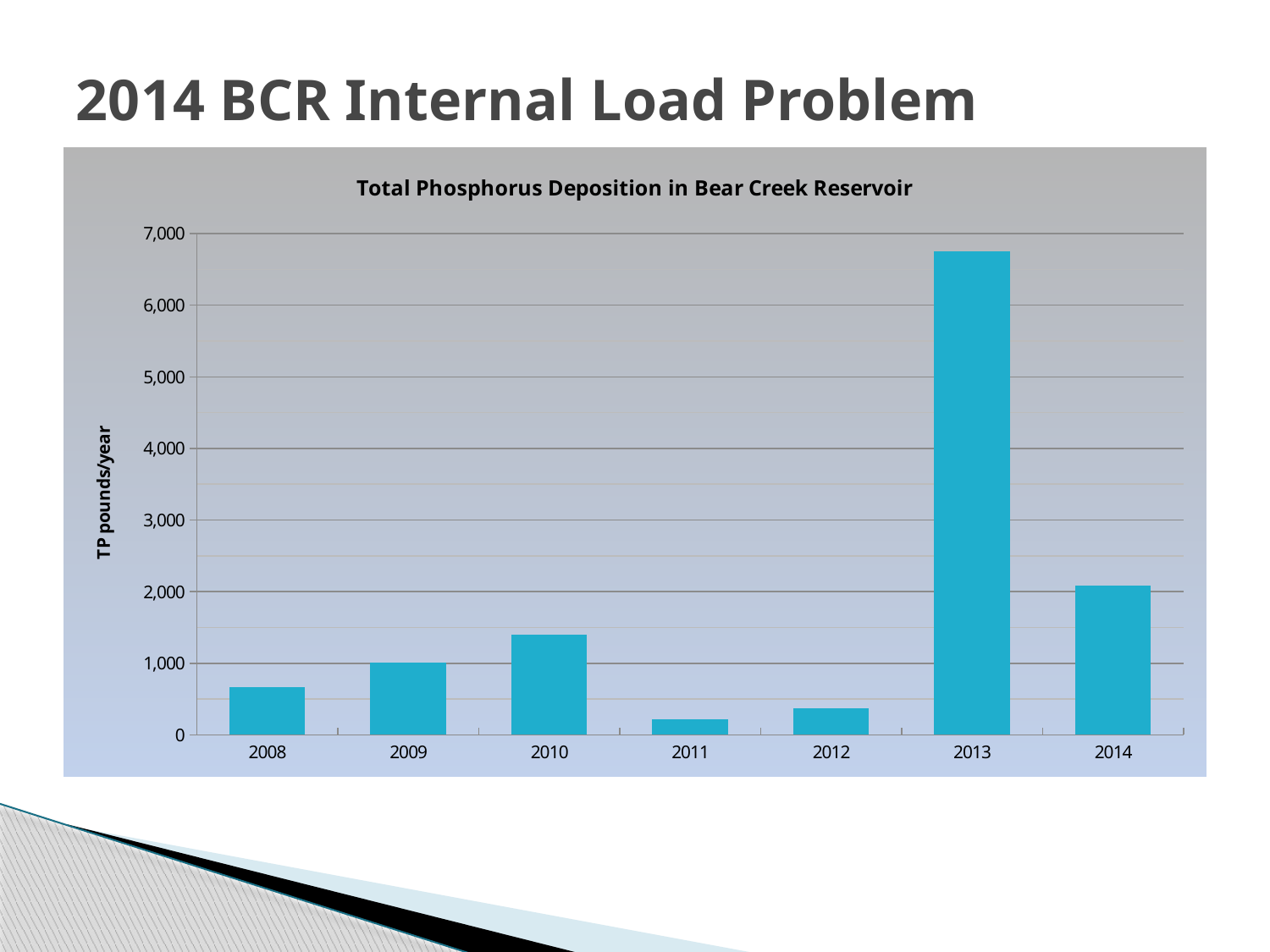
Which year has the highest total phosphorus deposition? 2013 Is the value for 2013 greater or less than 6,000? greater Which year has a larger value, 2010 or 2009? 2010 What type of chart is shown on the slide? Bar chart Do the values rise or fall from 2008 to 2010? rise Which year has the lowest total phosphorus deposition? 2011 What is the label on the vertical axis of the chart? TP pounds/year What is the title of the chart? Total Phosphorus Deposition in Bear Creek Reservoir Is the value for 2011 greater or less than 1,000? less Is the value for 2010 greater or less than 1,000? greater How many years are shown on the x axis of the chart? 7